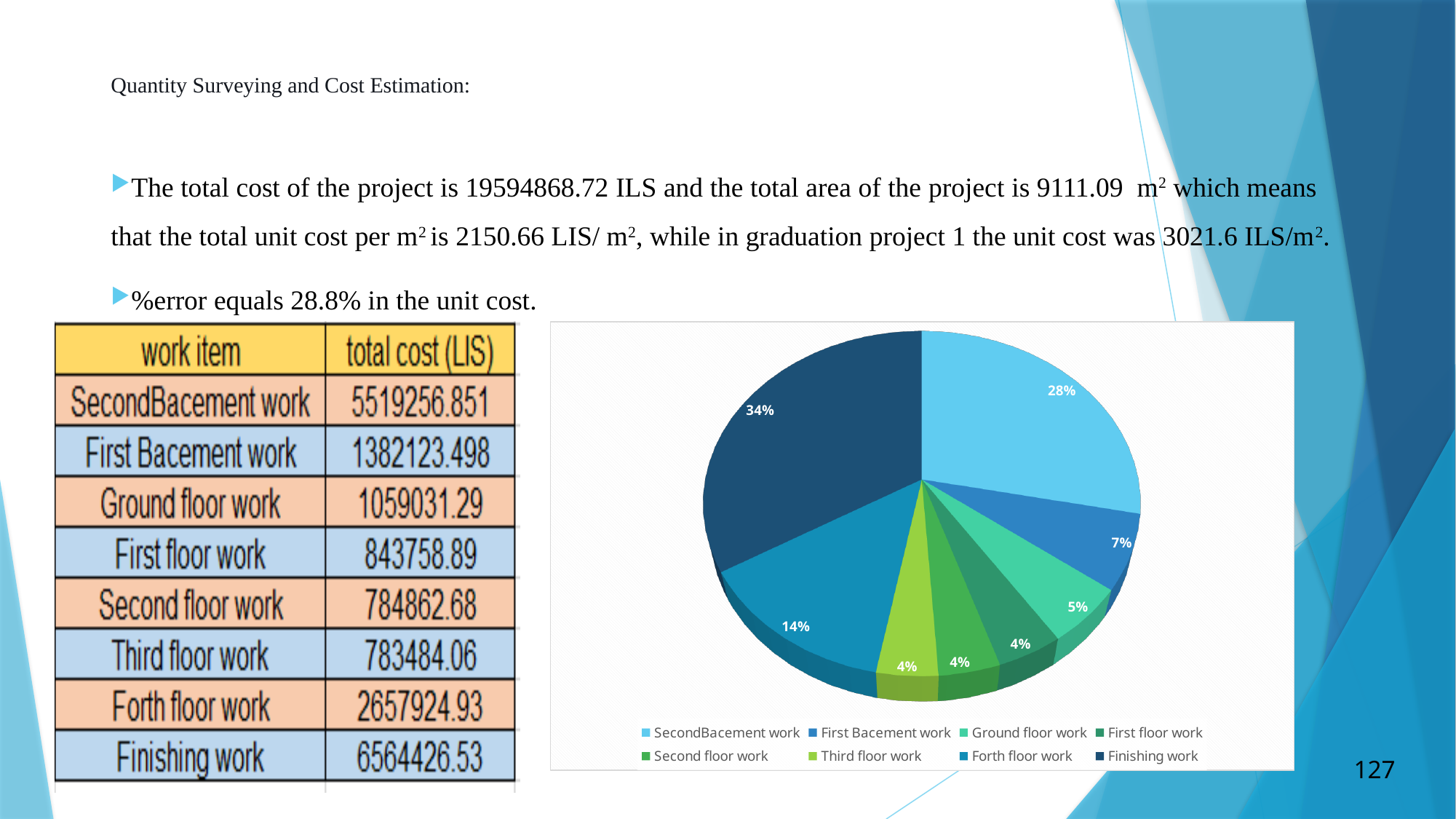
What share of the pie does Finishing work represent? 34% How many slices does the pie chart have? 8 Which legend entry is shown in the darkest blue colour in the pie chart? Finishing work What share of the pie does SecondBacement work represent? 28% Which work item has the largest slice of the pie? Finishing work Which is larger in the pie chart, the share for Forth floor work or the share for First Bacement work? Forth floor work How many entries does the pie chart's legend list? 8 What is the difference in percentage points between the Finishing work slice and the SecondBacement work slice? 6% What share of the pie does First Bacement work represent? 7% What kind of chart is shown on the slide? pie chart